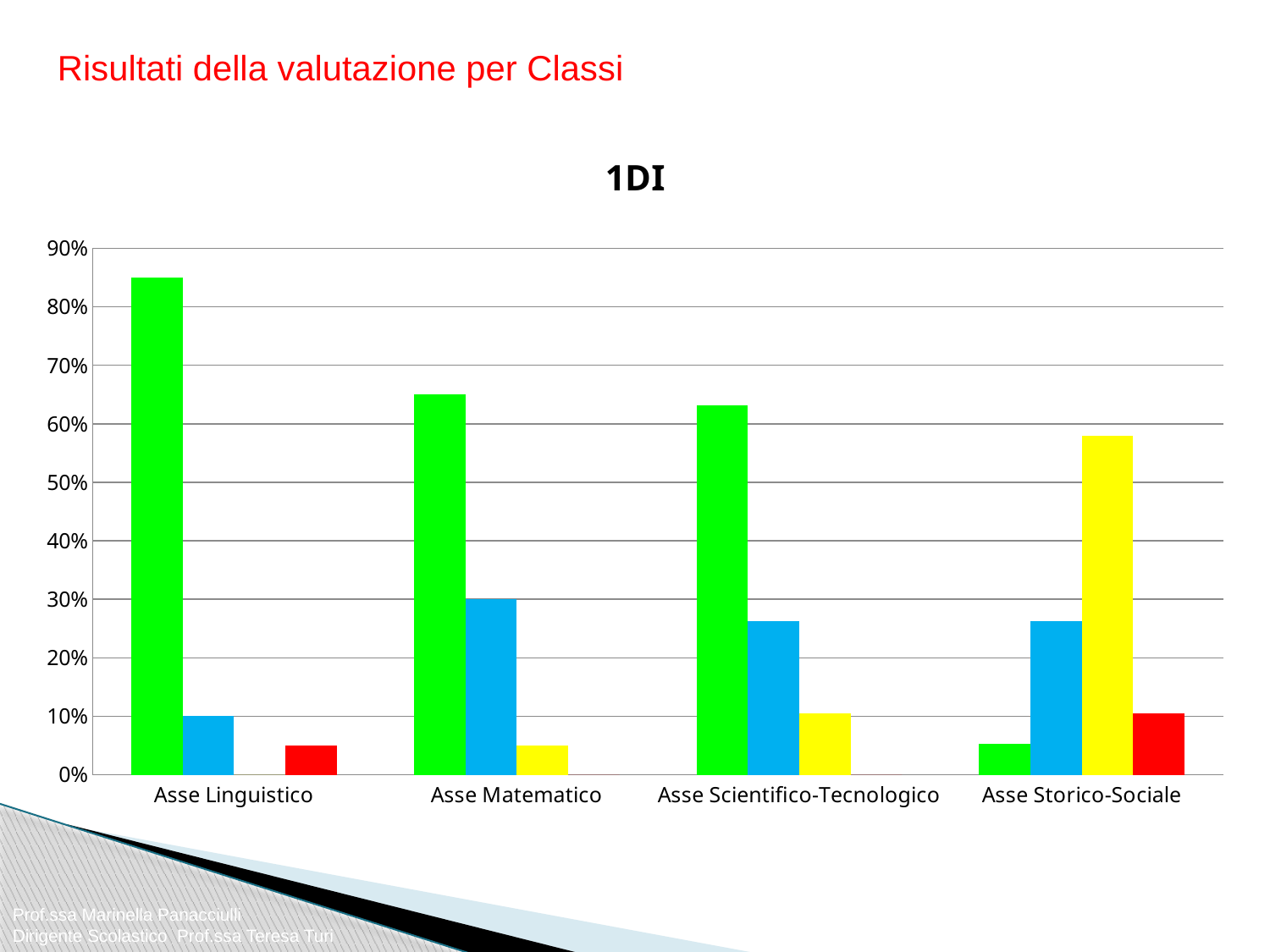
Which category has the tallest yellow bar? Asse Storico-Sociale Which is larger: the green bar for Asse Linguistico or the yellow bar for Asse Storico-Sociale? the green bar for Asse Linguistico How many categories are shown on the x axis of the chart? 4 Is the yellow bar for Asse Storico-Sociale greater or less than 50%? greater Is the green bar for Asse Storico-Sociale greater or less than 10%? less Which category has the shortest green bar? Asse Storico-Sociale What is the title of the chart? 1DI Which category has the tallest green bar? Asse Linguistico Is the green bar for Asse Linguistico greater or less than 80%? greater How many different bar colours are used in the chart? 4 What kind of chart is shown on the slide? bar chart